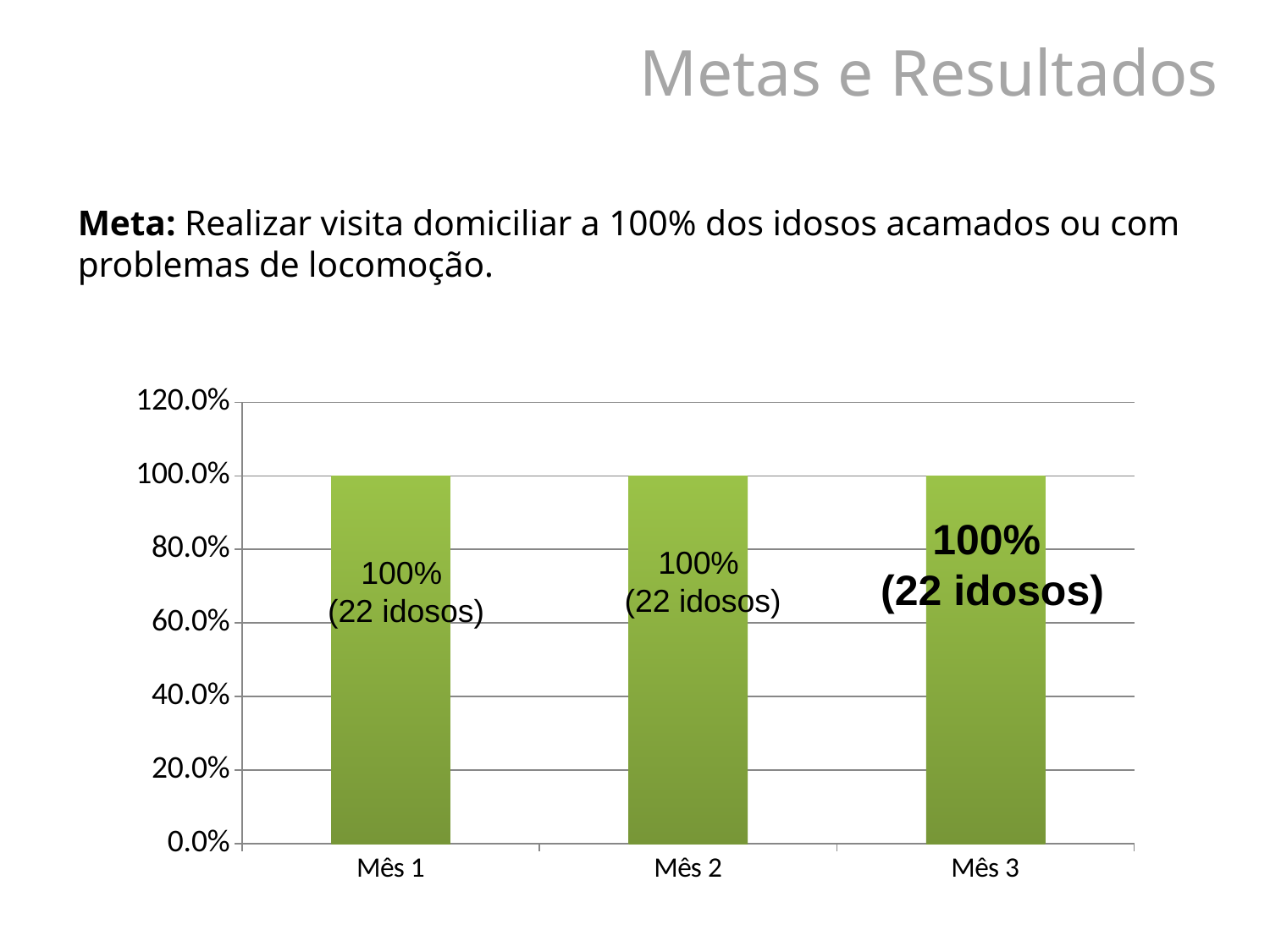
Is the value for Mês 2 greater or less than 80.0%? greater What is the value shown for Mês 1? 100% Do the values rise, fall, or stay the same from Mês 1 to Mês 3? Stay the same Is the value for Mês 1 greater or less than 120.0%? less What is the value shown for Mês 2? 100% What is the difference between the values for Mês 1 and Mês 3? 0% What kind of chart is shown on the slide? Bar chart What is the highest tick label on the y axis? 120.0% What is the value shown for Mês 3? 100% How many categories are plotted on the x axis? 3 How many idosos does the label on the Mês 3 bar report? 22 idosos What is the label of the first category on the x axis? Mês 1